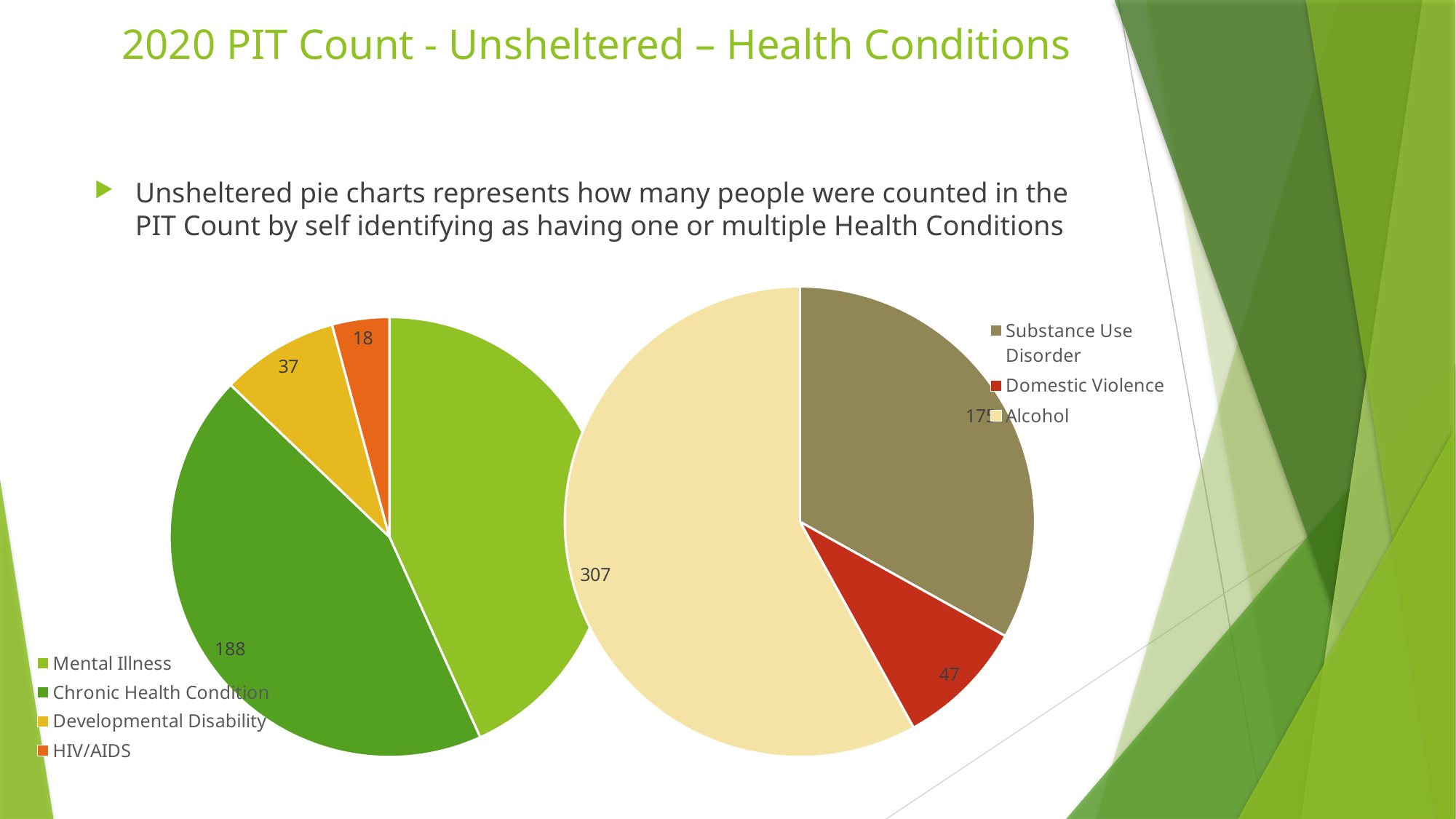
In the right pie chart, what is the value for Alcohol? 307 In the left pie chart, which category has the smallest slice? HIV/AIDS In the right pie chart, which category has the largest slice? Alcohol In the left pie chart, what is the value for Chronic Health Condition? 188 How many categories does the legend of the left pie chart list? 4 In the left pie chart, what is the value for Developmental Disability? 37 In the right pie chart, which category has the smallest slice? Domestic Violence In the right pie chart, what is the difference between the Alcohol value and the Domestic Violence value? 260 What kind of chart is used on this slide? Pie chart In the left pie chart, what is the value for HIV/AIDS? 18 In the right pie chart, what is the value for Domestic Violence? 47